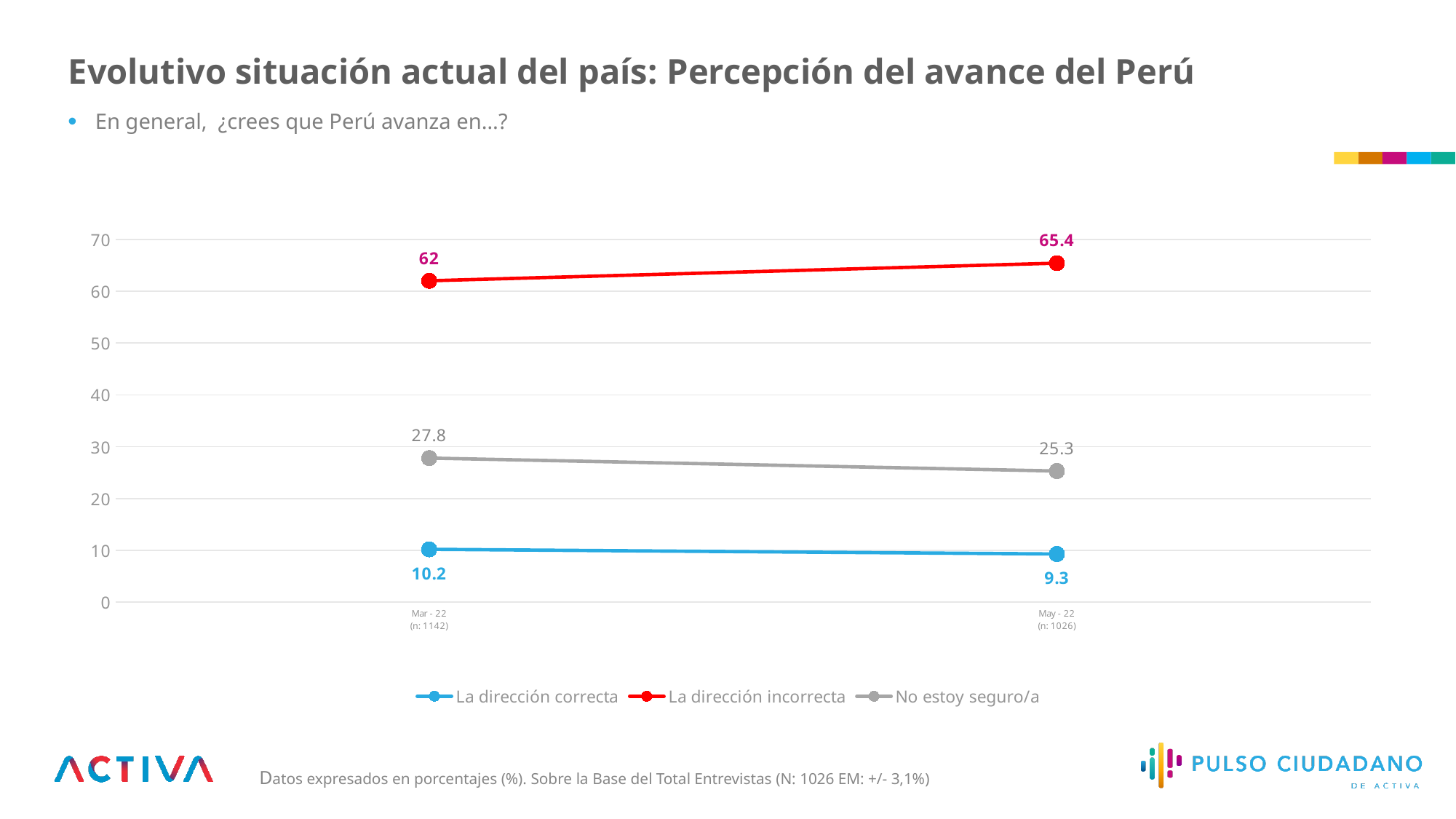
What is the value for 'La dirección incorrecta' in Mar - 22? 62 What is the difference between the 'La dirección incorrecta' values in May - 22 and Mar - 22? 3.4 What is the value for 'La dirección correcta' in Mar - 22? 10.2 Which series has the highest value in May - 22? La dirección incorrecta How many series does the legend list? 3 What is the difference between the 'No estoy seguro/a' values in Mar - 22 and May - 22? 2.5 Which series has the lowest value in Mar - 22? La dirección correcta What is the value for 'No estoy seguro/a' in May - 22? 25.3 Which is larger: 'No estoy seguro/a' in Mar - 22 or 'La dirección correcta' in Mar - 22? No estoy seguro/a in Mar - 22 What kind of chart is shown on the slide? Line chart What is the value for 'La dirección incorrecta' in May - 22? 65.4 Does the 'La dirección correcta' series rise or fall from Mar - 22 to May - 22? Fall